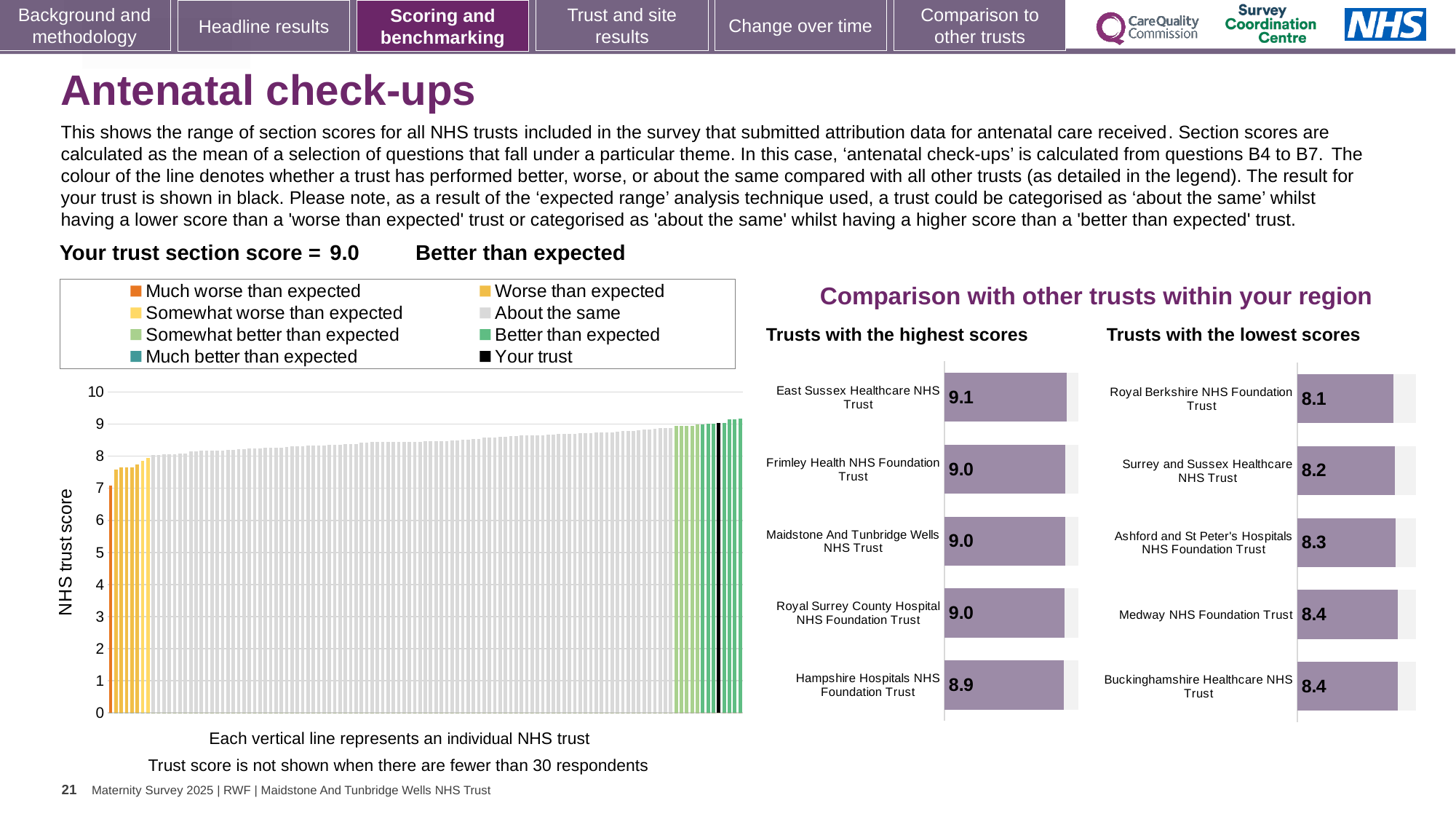
How many trusts are shown in the 'Trusts with the highest scores' chart? 5 How many entries does the legend of the NHS trust score chart list? 8 In the 'Trusts with the lowest scores' chart, what is the score for Medway NHS Foundation Trust? 8.4 In the 'Trusts with the lowest scores' chart, which has the higher score: Surrey and Sussex Healthcare NHS Trust or Ashford and St Peter's Hospitals NHS Foundation Trust? Ashford and St Peter's Hospitals NHS Foundation Trust In the 'Trusts with the lowest scores' chart, what is the difference between the scores of Buckinghamshire Healthcare NHS Trust and Royal Berkshire NHS Foundation Trust? 0.3 Do the values in the NHS trust score chart rise or fall from left to right along the x axis? rise In the 'Trusts with the lowest scores' chart, which trust has the lowest score? Royal Berkshire NHS Foundation Trust In the 'Trusts with the highest scores' chart, which trust has the highest score? East Sussex Healthcare NHS Trust In the 'Trusts with the highest scores' chart, what is the score for Hampshire Hospitals NHS Foundation Trust? 8.9 In the 'Trusts with the highest scores' chart, what is the difference between the scores of East Sussex Healthcare NHS Trust and Hampshire Hospitals NHS Foundation Trust? 0.2 In the 'Trusts with the highest scores' chart, what is the score for East Sussex Healthcare NHS Trust? 9.1 In the 'Trusts with the lowest scores' chart, what is the score for Royal Berkshire NHS Foundation Trust? 8.1